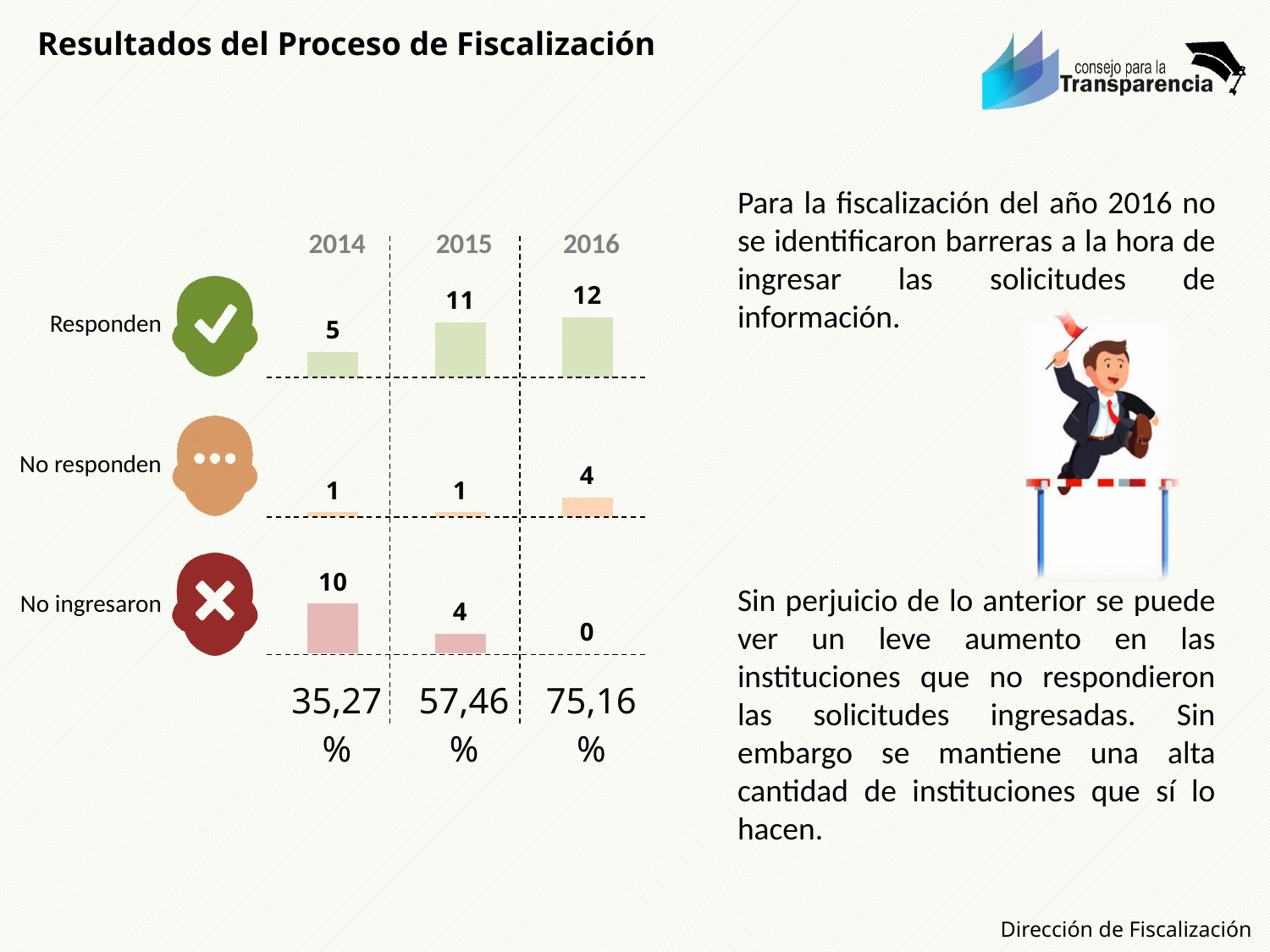
In which year is the value for Responden highest? 2016 Which is larger in 2014: the value for Responden or the value for No ingresaron? No ingresaron What is the value for No ingresaron in 2014? 10 How do the values for Responden change from 2014 to 2016? They rise What is the value for Responden in 2016? 12 What is the value for No responden in 2015? 1 What kind of chart is used to show the values for each year? Bar chart How do the values for No ingresaron change from 2014 to 2016? They fall What percentage is shown below the 2015 column? 57,46% What is the total of the three values shown for 2016 (Responden, No responden, No ingresaron)? 16 What is the difference between the Responden values for 2015 and 2014? 6 In which year is the value for No ingresaron lowest? 2016